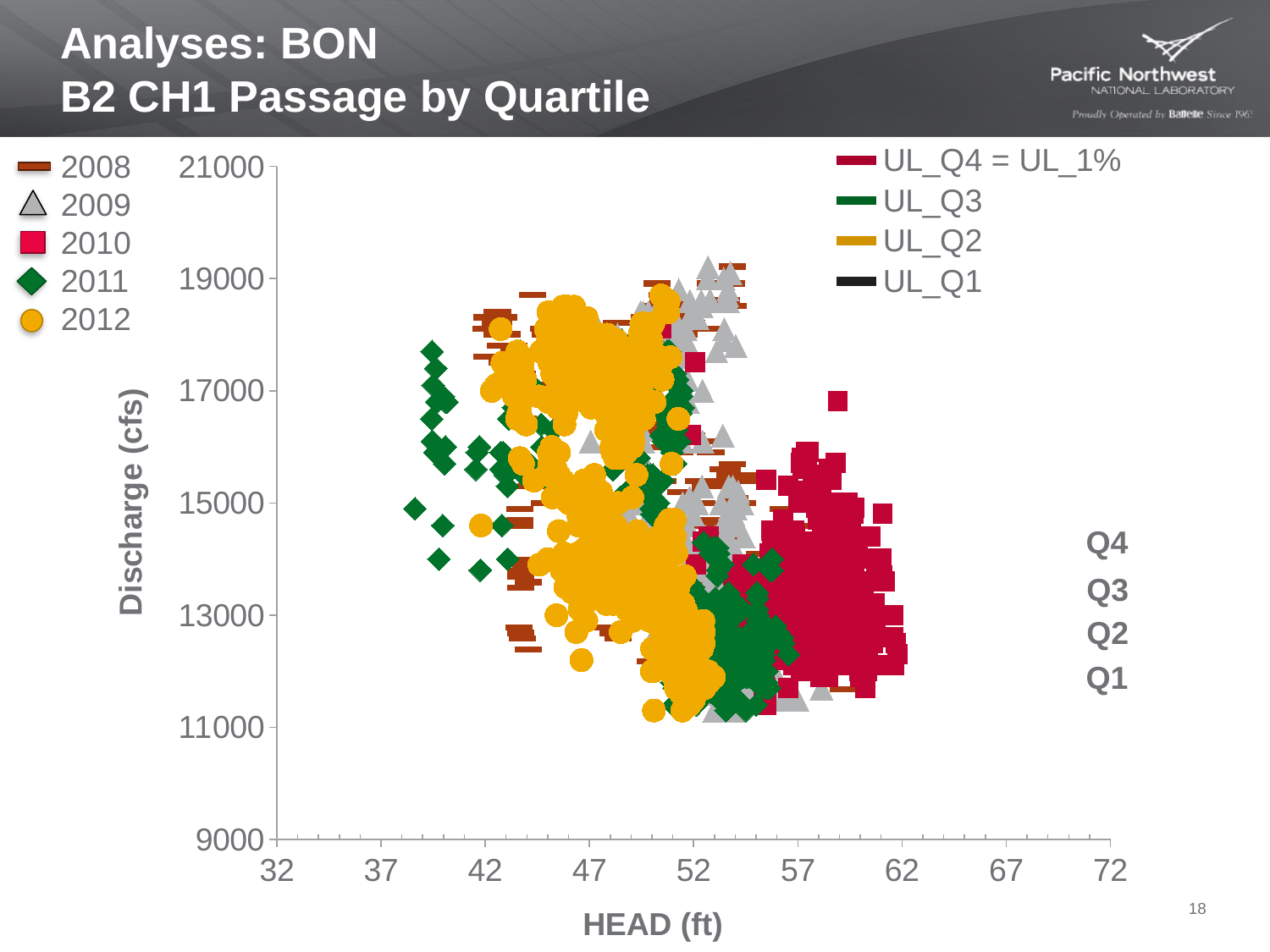
Are the 2011 points on the left side of the chart at HEAD values greater or less than 42? less Which year's points extend to the lowest HEAD values (furthest left)? 2011 How many years are listed in the legend on the left of the chart? 5 Are the 2010 points mostly at HEAD values greater or less than 52? greater What is the highest value shown on the Discharge (cfs) axis? 21000 Which year's points are plotted at the highest HEAD values (furthest right)? 2010 What kind of chart is shown on the slide? Scatter chart How many UL_Q entries are listed in the legend on the right of the chart? 4 What is the label of the x axis? HEAD (ft) Do the 2010 points lie at higher or lower HEAD values than the 2012 points? higher Which years are listed in the legend on the left of the chart? 2008, 2009, 2010, 2011, 2012 What is the lowest value shown on the HEAD (ft) axis? 32